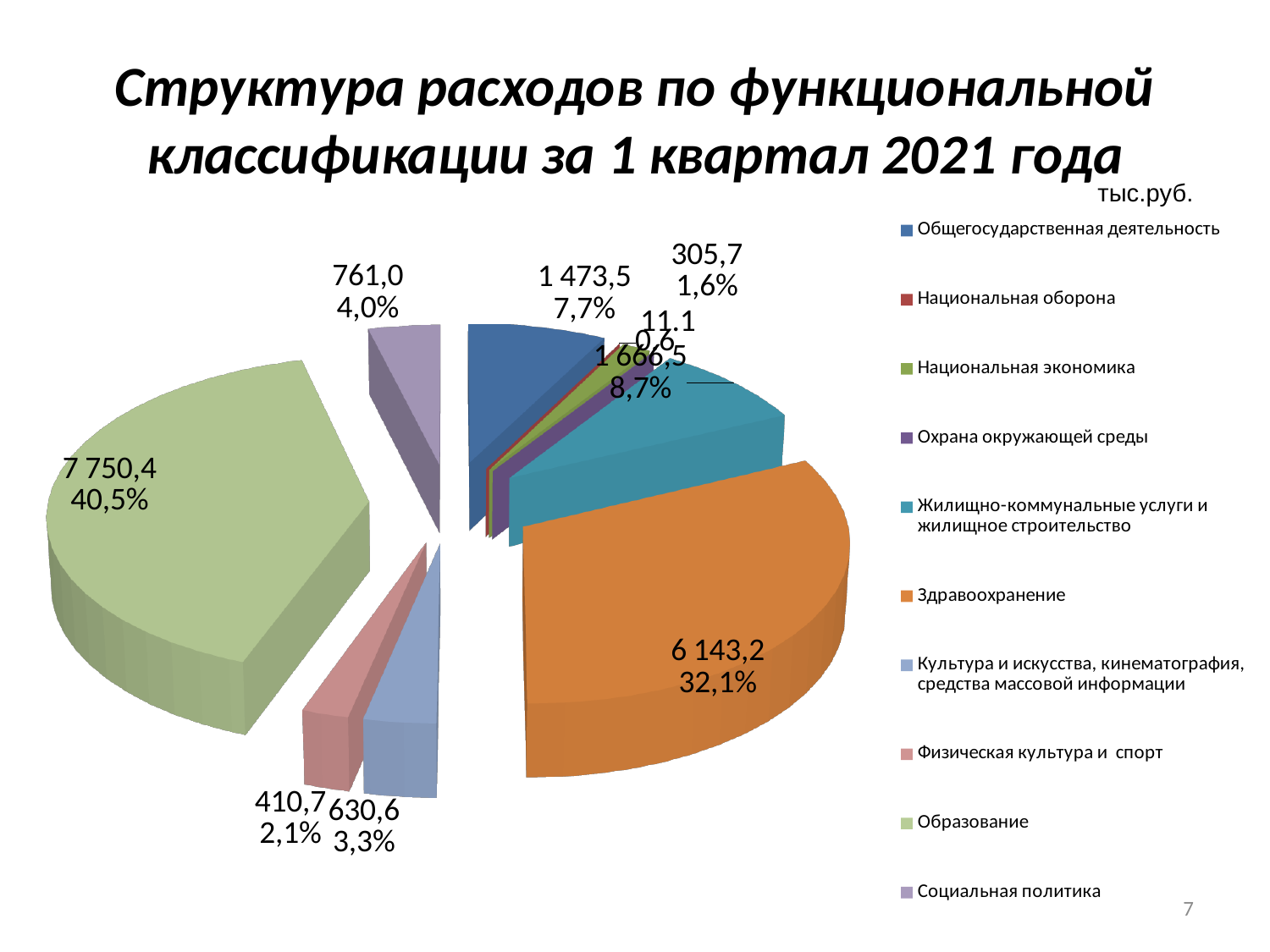
What share of the pie does Жилищно-коммунальные услуги и жилищное строительство account for? 8,7% How many categories does the legend of the pie chart list? 10 Which category has the largest share of expenditures in the pie chart? Образование What is the value shown for Социальная политика? 761,0 What is the difference between the values for Образование and Здравоохранение? 1 607,2 What kind of chart is shown on the slide? pie chart What is the value shown for Образование? 7 750,4 What is the value shown for Здравоохранение? 6 143,2 In what units are the values on the chart given, according to the slide? тыс.руб. What share of the pie does Физическая культура и спорт account for? 2,1% Which is larger: the value for Общегосударственная деятельность or the value for Жилищно-коммунальные услуги и жилищное строительство? Жилищно-коммунальные услуги и жилищное строительство What share of the pie does Здравоохранение account for? 32,1%